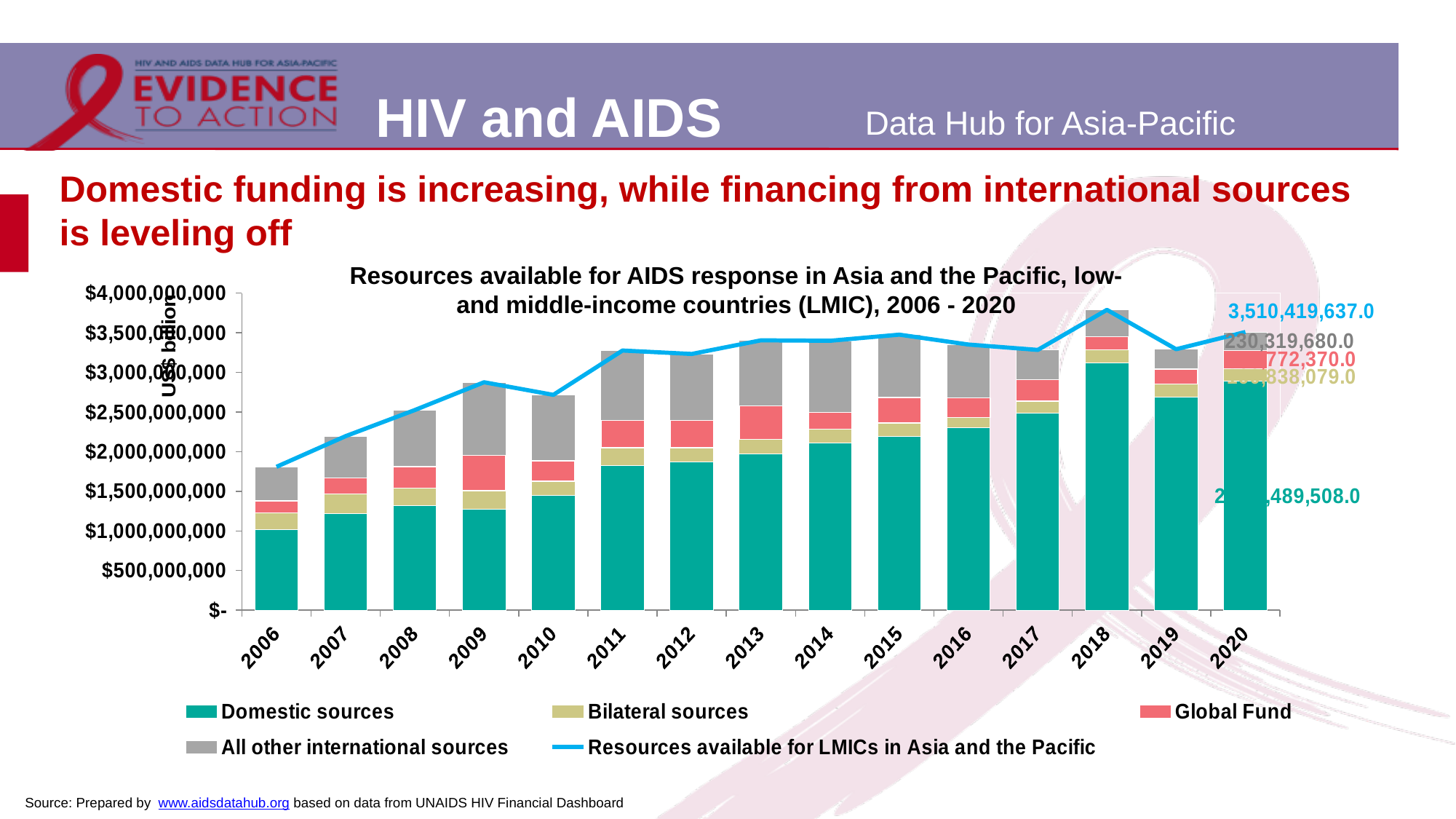
How many years are shown on the x axis of the chart? 15 What is the value of 'Resources available for LMICs in Asia and the Pacific' in 2020? 3,510,419,637.0 Which colour represents 'All other international sources' in the chart? grey Is the value for Domestic sources in 2006 greater or less than $1,500,000,000? less What kind of chart is shown on the slide? combination bar and line chart (stacked bars with a line) How many series does the chart legend list? 5 Which year has the shortest stacked bar? 2006 Do the Domestic sources values generally rise or fall from 2006 to 2020? rise Is the value for Domestic sources in 2018 greater or less than $3,000,000,000? greater Which year has the larger Domestic sources value, 2006 or 2020? 2020 Which year has the tallest stacked bar? 2018 Is the total height of the stacked bar for 2006 greater or less than $2,000,000,000? less